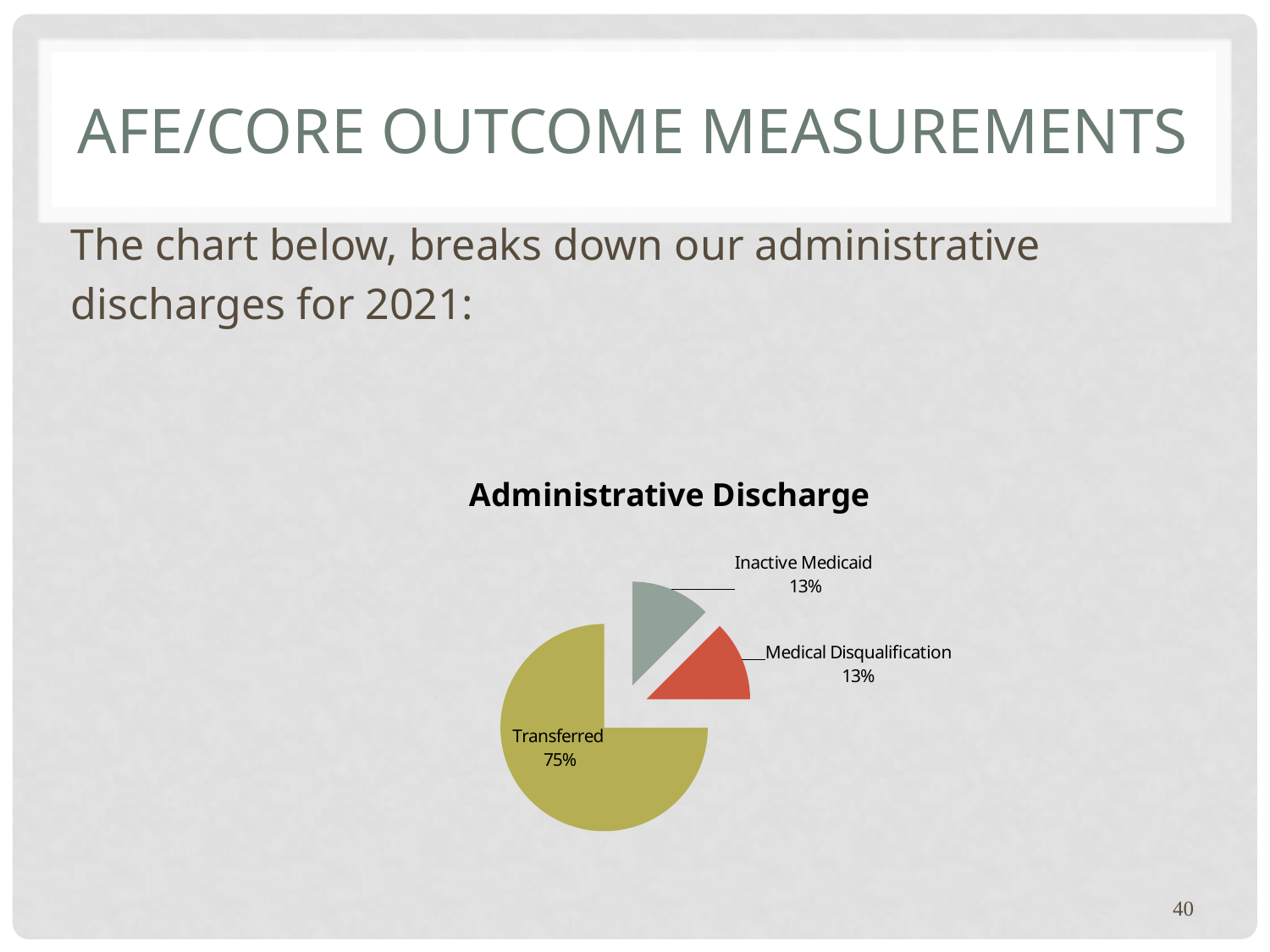
Which category has the largest slice of the pie? Transferred Which is larger, the Transferred slice or the Inactive Medicaid slice? Transferred What is the title of the chart? Administrative Discharge Which slice of the pie is coloured red? Medical Disqualification How many slices does the pie chart have? 3 What share of the pie is Medical Disqualification? 13% What is the difference in percentage points between the Transferred slice and the Medical Disqualification slice? 62 What share of the pie is Inactive Medicaid? 13% What share of the pie is Transferred? 75% What kind of chart is shown on the slide? pie chart